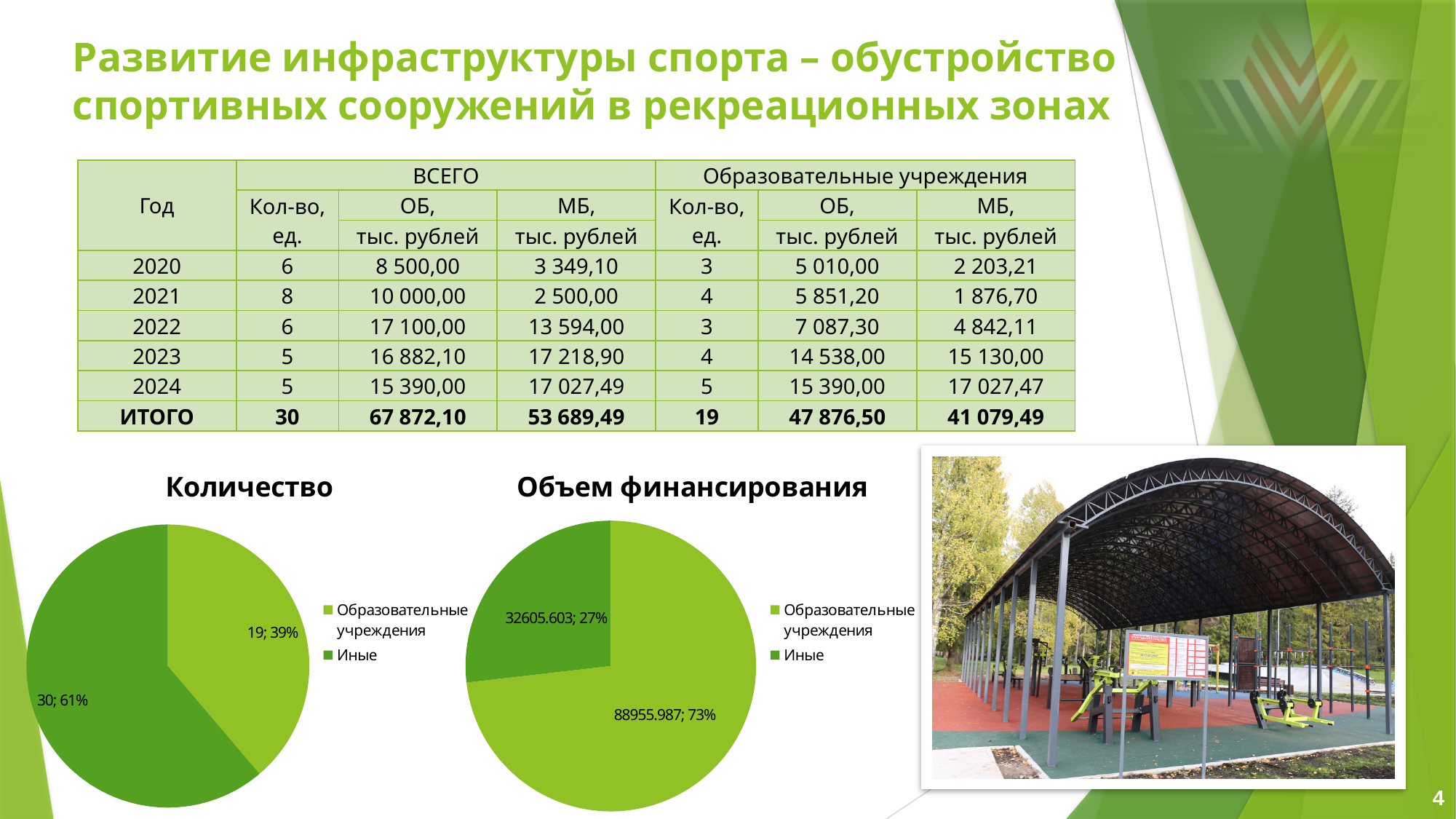
In the "Количество" chart, what share of the pie does Иные take? 61% In the "Объем финансирования" chart, what value is shown for Образовательные учреждения? 32605.603 In the "Количество" chart, what value is shown for Образовательные учреждения? 19 How many slices does the "Объем финансирования" pie chart have? 2 In the "Объем финансирования" chart, what share of the pie does Иные take? 73% In the "Объем финансирования" chart, what value is shown for Иные? 88955.987 What kind of chart is the "Количество" chart? pie chart In the "Объем финансирования" chart, which slice is the smallest? Образовательные учреждения In the "Количество" chart, what value is shown for Иные? 30 In the "Количество" chart, which slice is larger, Образовательные учреждения or Иные? Иные How many entries does the legend of the "Количество" chart list? 2 In the "Количество" chart, what share of the pie does Образовательные учреждения take? 39%